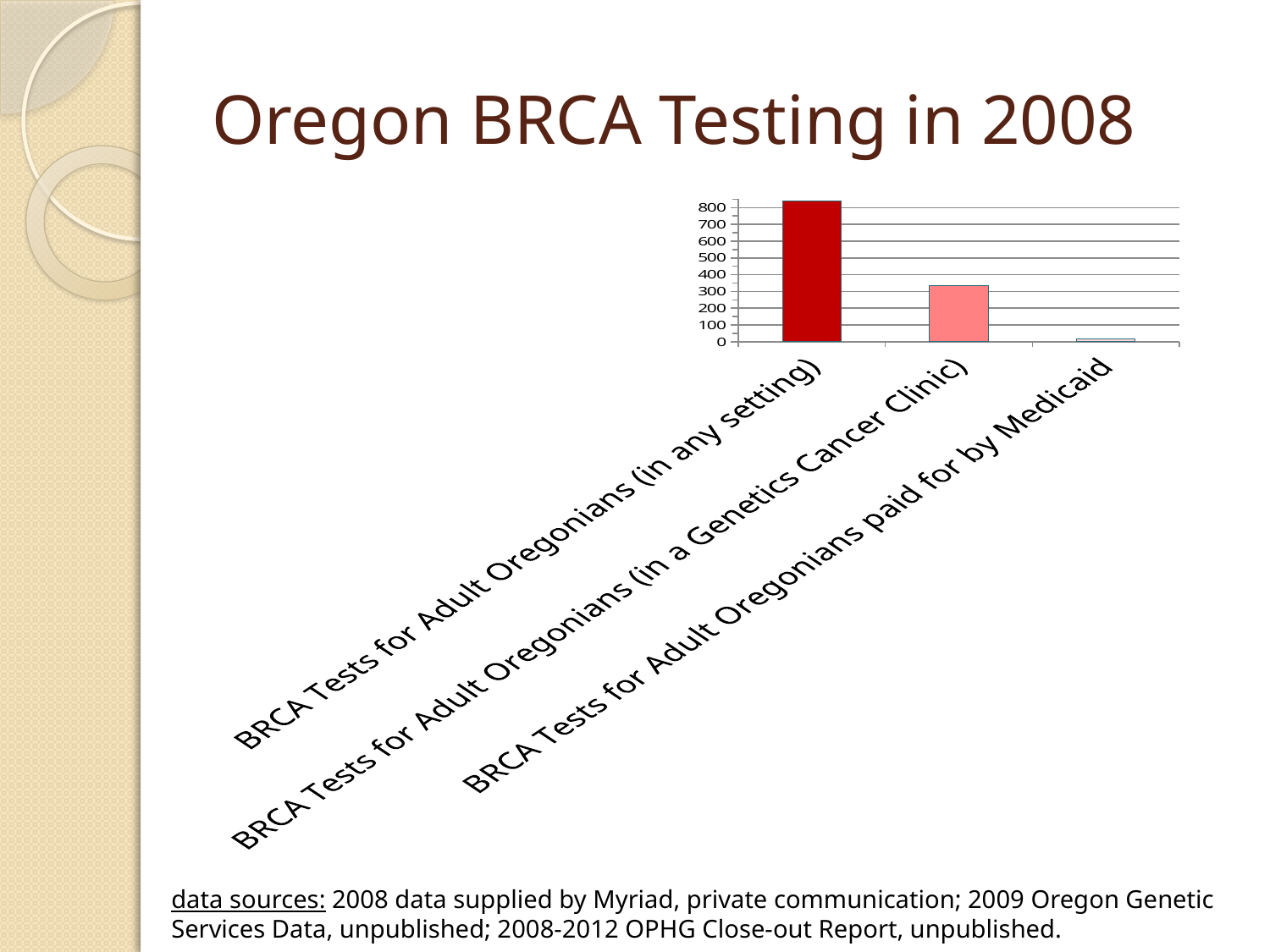
Which category has the lowest value? BRCA Tests for Adult Oregonians paid for by Medicaid Is the value for BRCA Tests for Adult Oregonians (in a Genetics Cancer Clinic) greater or less than 400? less Is the value for BRCA Tests for Adult Oregonians (in any setting) greater or less than 800? greater Which category has the highest value? BRCA Tests for Adult Oregonians (in any setting) Is the value for BRCA Tests for Adult Oregonians paid for by Medicaid greater or less than 100? less What is the title of the slide containing the chart? Oregon BRCA Testing in 2008 Do the bar values rise or fall from left to right across the chart? fall What kind of chart is shown on the slide? bar chart What is the highest value labelled on the vertical axis of the chart? 800 How many categories (bars) does the chart show? 3 Which is larger: the value for BRCA Tests for Adult Oregonians (in a Genetics Cancer Clinic) or the value for BRCA Tests for Adult Oregonians paid for by Medicaid? BRCA Tests for Adult Oregonians (in a Genetics Cancer Clinic)